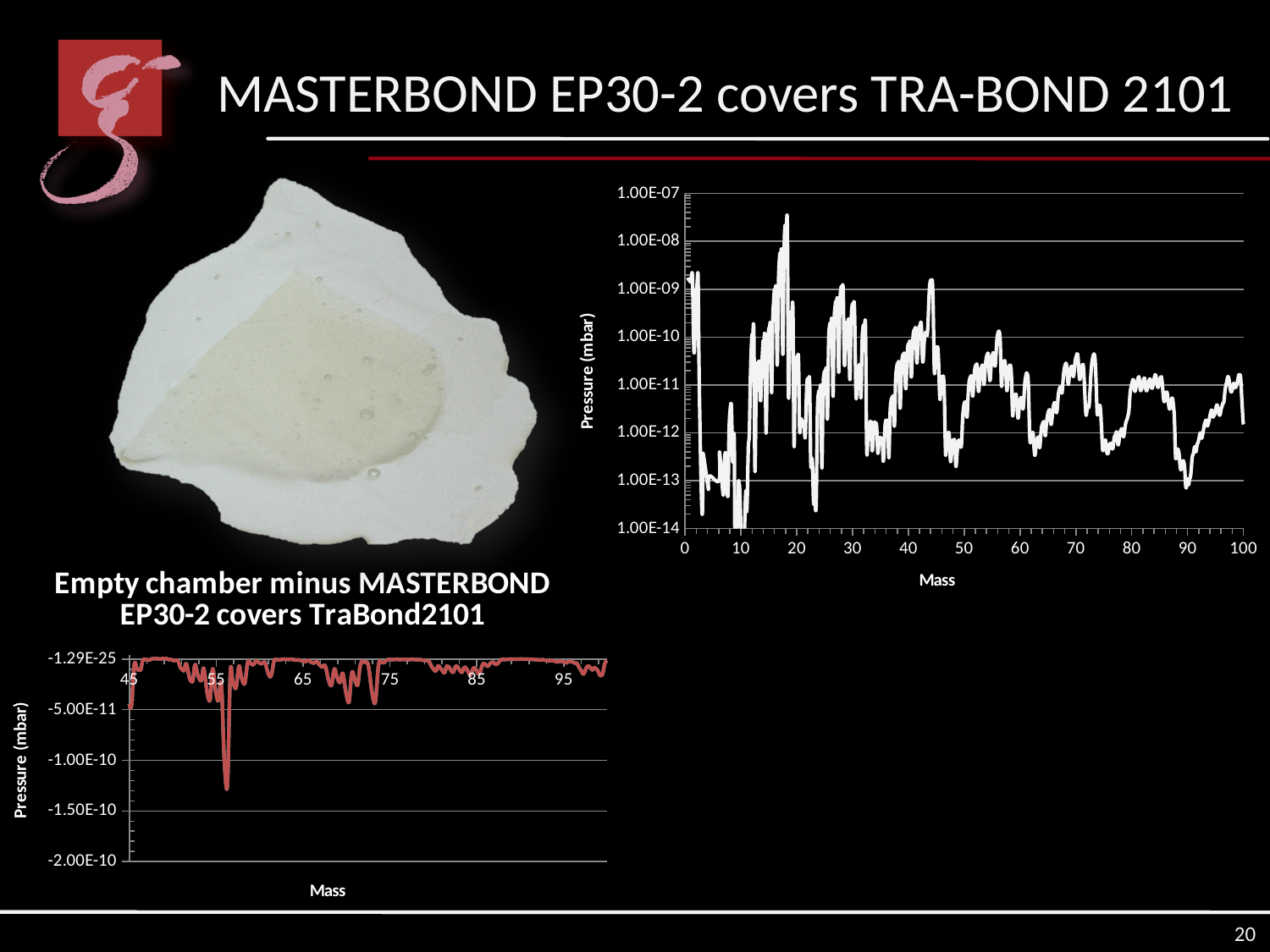
In the chart on the right, what is the label of the y axis? Pressure (mbar) What kind of chart is the chart on the right of the slide? line chart In the chart on the right, is the pressure at mass 100 greater or less than 1.00E-10? less In the chart on the right, is the pressure at the highest peak (near mass 18) greater or less than 1.00E-09? greater In the chart on the right, is the pressure at the peak near mass 44 greater or less than 1.00E-10? greater What is the title of the chart at the bottom left of the slide? Empty chamber minus MASTERBOND EP30-2 covers TraBond2101 In the chart on the right, which mass region has the highest pressure peak: around mass 18 or around mass 90? around mass 18 In the bottom-left chart, which dip is deeper: the one near mass 57 or the one near mass 75? the one near mass 57 What kind of chart is the chart at the bottom left of the slide? line chart